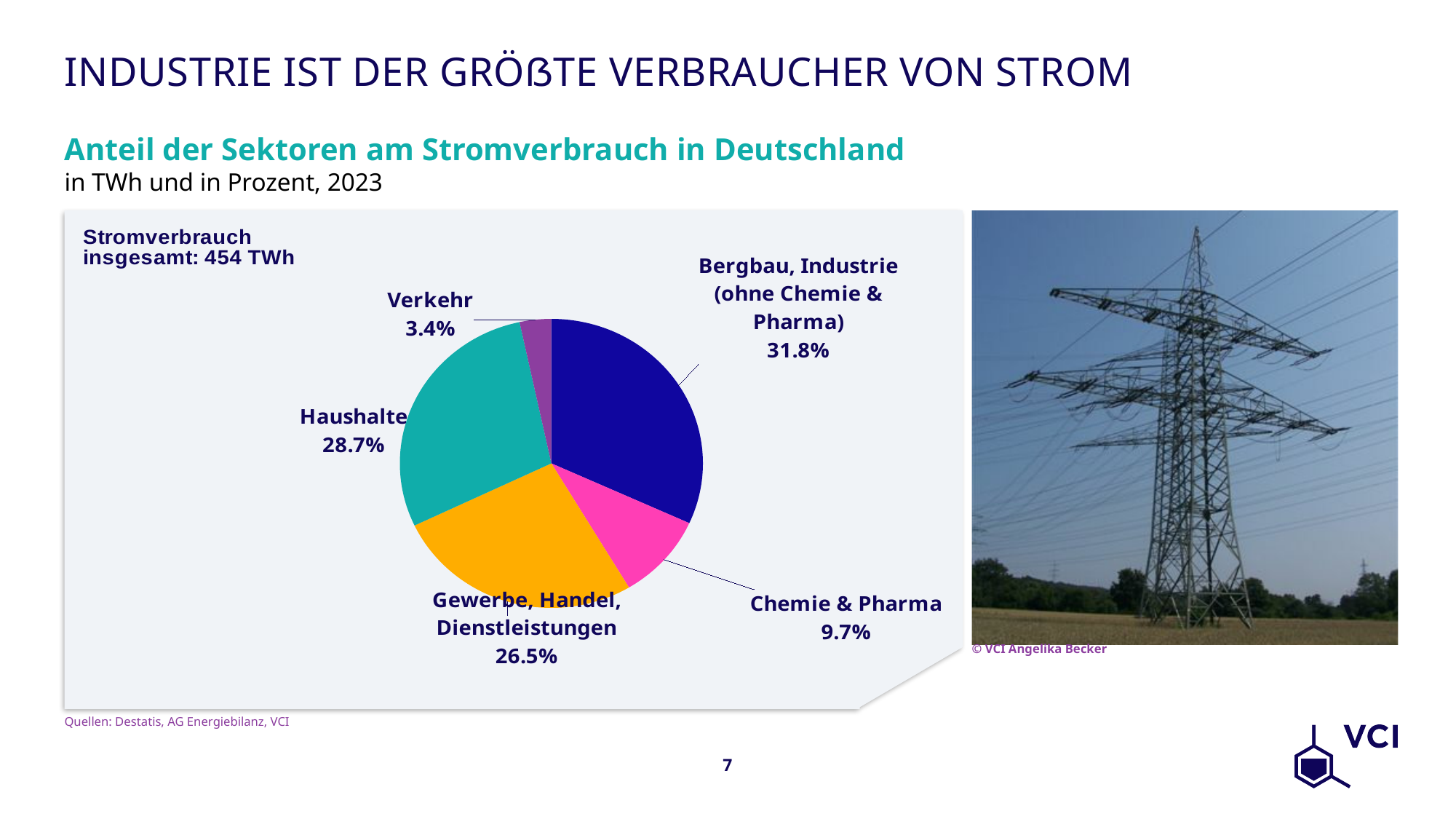
What share is shown for Chemie & Pharma? 9.7% What share is shown for Verkehr? 3.4% What is the total electricity consumption stated on the chart? 454 TWh What share is shown for Gewerbe, Handel, Dienstleistungen? 26.5% Which sector has the smallest share of electricity consumption? Verkehr What colour is the Haushalte slice? Teal What share of electricity consumption does the Haushalte slice represent? 28.7% Which sector has the largest share of electricity consumption? Bergbau, Industrie (ohne Chemie & Pharma) What is the difference in percentage points between Haushalte and Gewerbe, Handel, Dienstleistungen? 2.2 percentage points How many sectors are shown in the pie chart? 5 Which has a larger share: Chemie & Pharma or Verkehr? Chemie & Pharma What kind of chart is shown on the slide? Pie chart